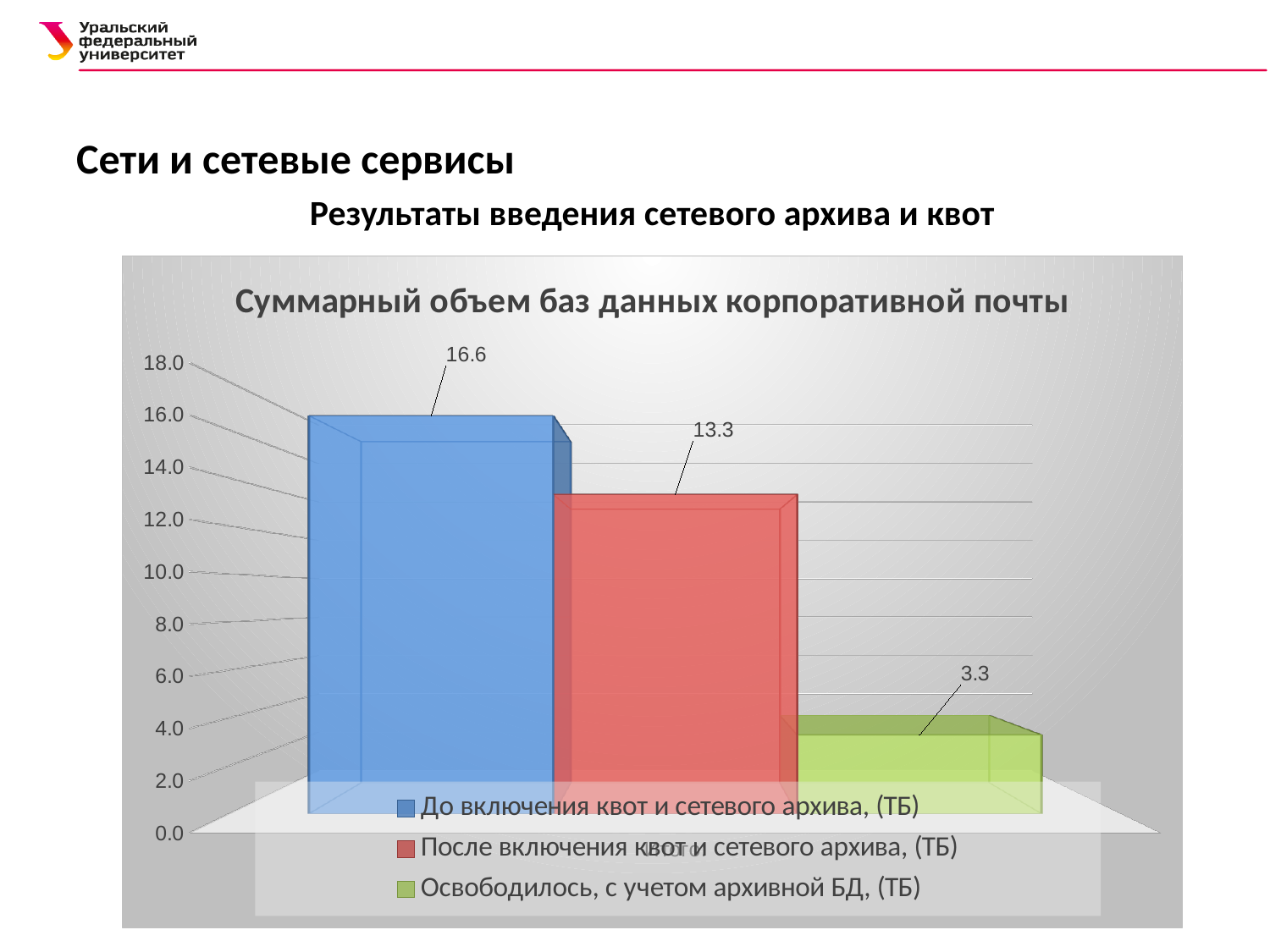
What is the title of the chart? Суммарный объем баз данных корпоративной почты Which is larger: the value 'До включения квот и сетевого архива' or 'После включения квот и сетевого архива'? До включения квот и сетевого архива, (ТБ) Which series has the lowest value? Освободилось, с учетом архивной БД, (ТБ) Is the value for 'До включения квот и сетевого архива, (ТБ)' greater or less than 16.0? greater What is the difference between the value before quotas (16.6) and after quotas (13.3)? 3.3 How many series does the legend list? 3 Which series has the highest value? До включения квот и сетевого архива, (ТБ) What kind of chart is shown on the slide? bar chart Is the value for 'Освободилось, с учетом архивной БД, (ТБ)' greater or less than 4.0? less What is the value for 'До включения квот и сетевого архива, (ТБ)'? 16.6 What is the value for 'После включения квот и сетевого архива, (ТБ)'? 13.3 What is the value for 'Освободилось, с учетом архивной БД, (ТБ)'? 3.3